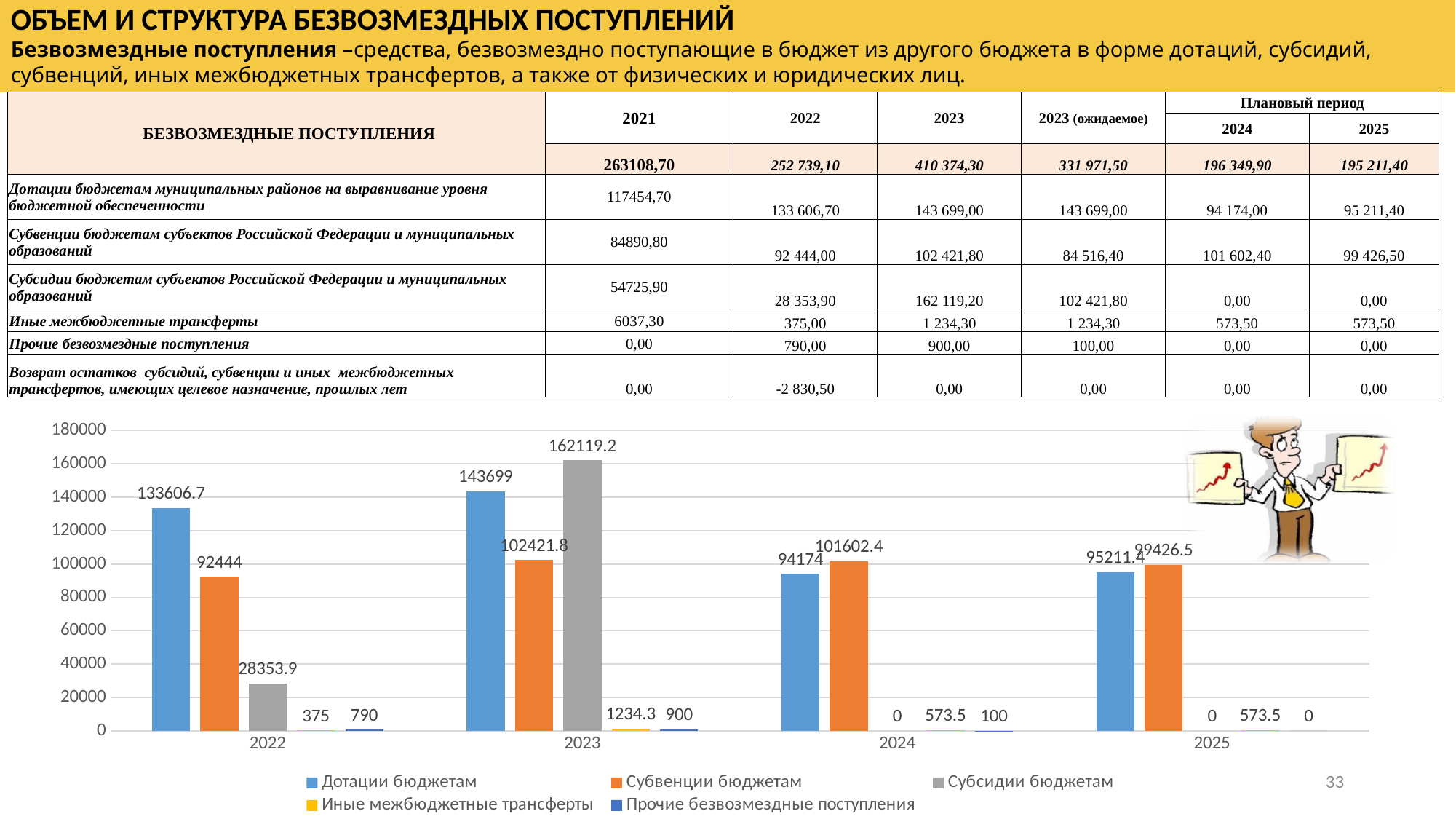
What is the value of Субсидии бюджетам for 2023 in the chart? 162119.2 Which series has the highest value in 2023 in the chart? Субсидии бюджетам What type of chart is shown at the bottom of the slide? bar chart Is the value of Субвенции бюджетам for 2022 greater or less than 100000 in the chart? less Which series has the lowest value in 2022 in the chart? Иные межбюджетные трансферты In the chart, which is larger in 2024: Дотации бюджетам or Субвенции бюджетам? Субвенции бюджетам What is the value of Дотации бюджетам for 2022 in the chart? 133606.7 How many year categories are shown on the x axis of the chart? 4 What is the difference between Дотации бюджетам in 2023 and in 2022 in the chart? 10092.3 What is the value of Субвенции бюджетам for 2024 in the chart? 101602.4 How many series does the chart legend list? 5 What is the value of Иные межбюджетные трансферты for 2025 in the chart? 573.5